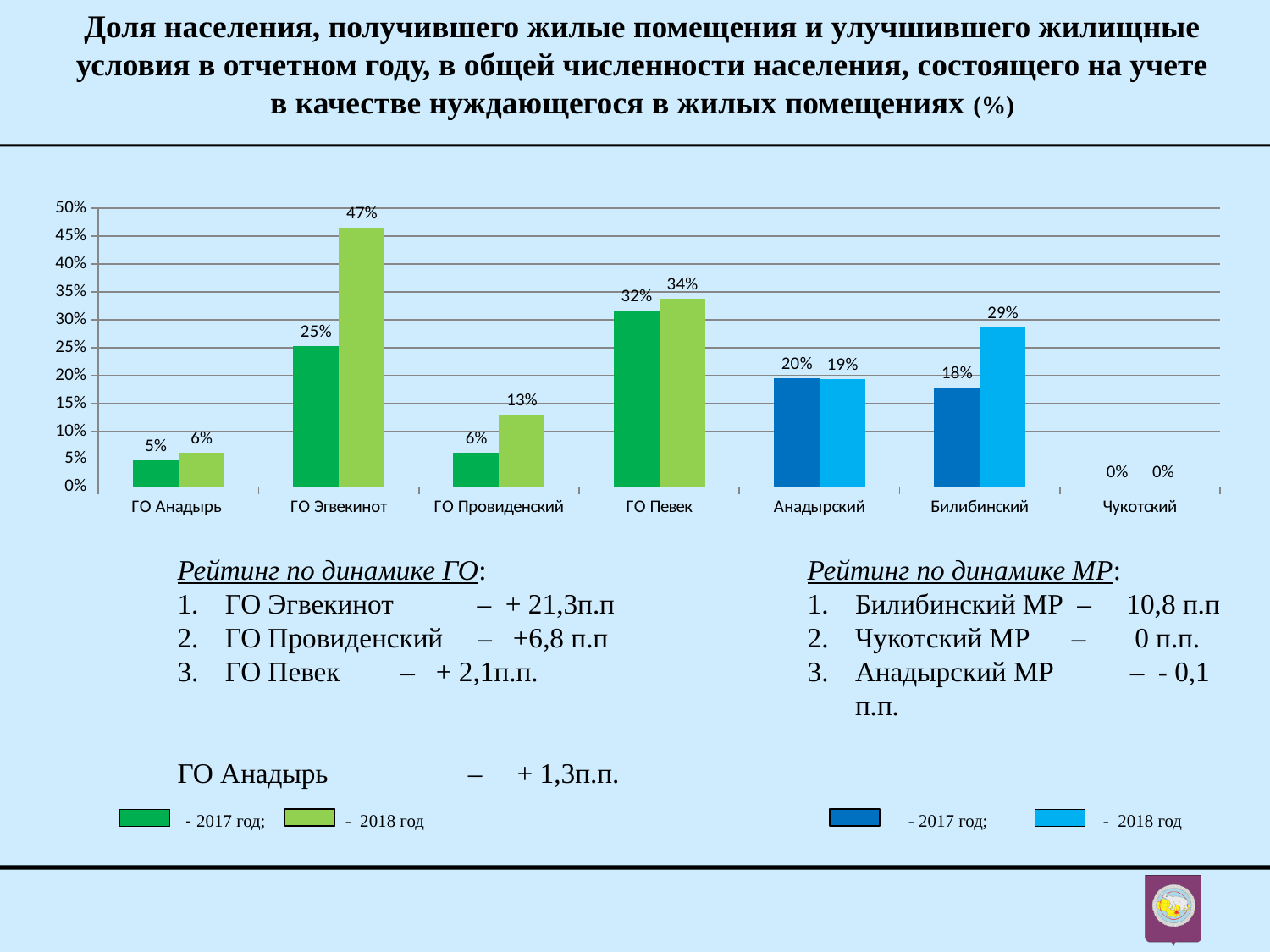
Which is larger for ГО Провиденский, the 2017 value or the 2018 value? 2018 What kind of chart is shown on the slide? Bar chart Which two years does the chart legend list? 2017 and 2018 How many categories are shown on the x axis of the chart? 7 What is the 2018 value for Билибинский? 29% What is the 2017 value for Анадырский? 20% What is the 2018 value for ГО Эгвекинот? 47% Which category has the highest 2018 value? ГО Эгвекинот Which category has the lowest 2017 value? Чукотский What is the 2017 value for ГО Певек? 32% What is the difference between the 2018 and 2017 values for Билибинский? 11% What is the difference between the 2018 and 2017 values for ГО Эгвекинот? 22%